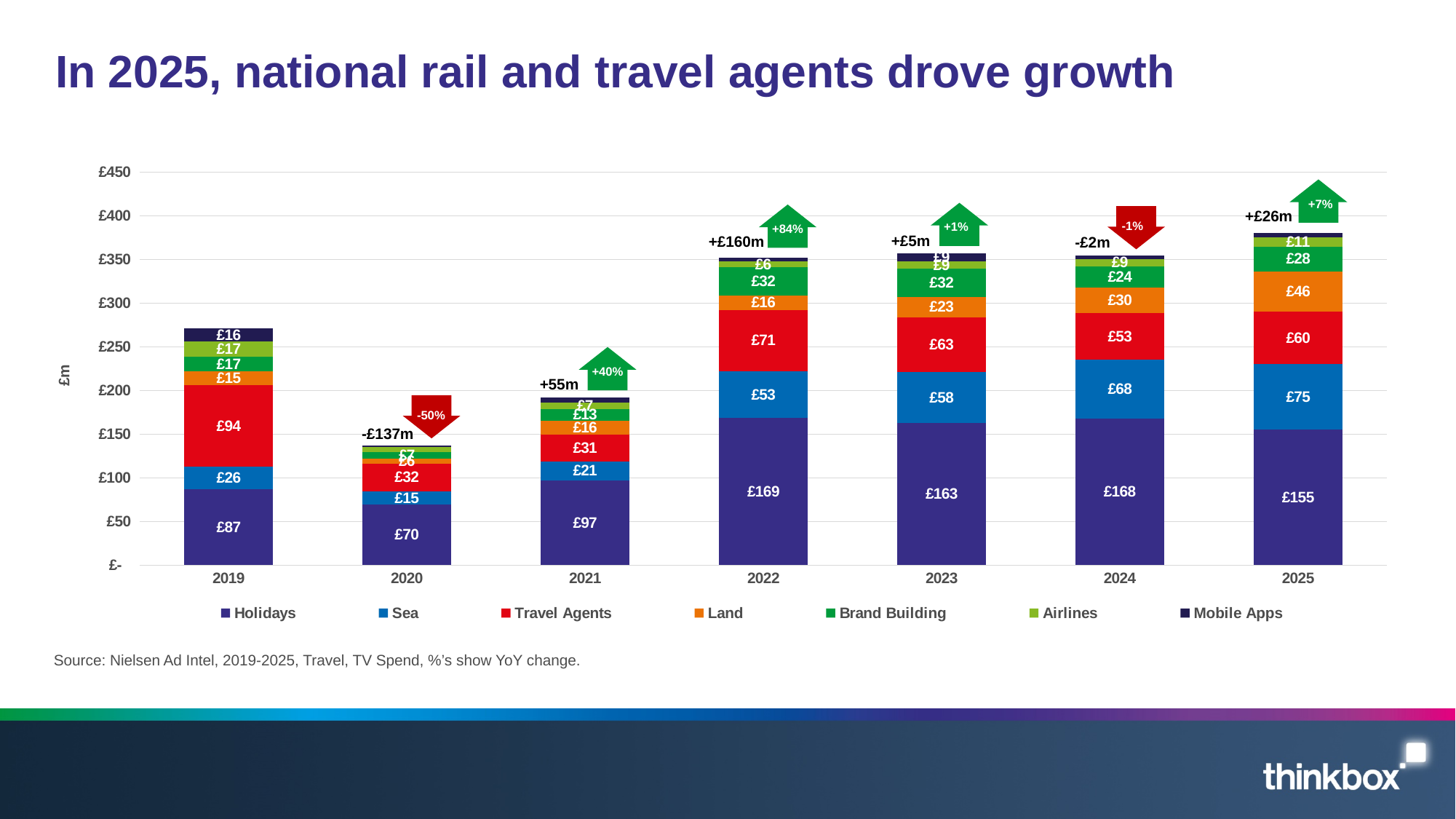
Is the total height of the 2025 bar greater or less than £350? greater In which year is the Holidays segment highest? 2022 Which is larger, the Sea value in 2024 or in 2025? 2025 What kind of chart is shown on the slide? Stacked bar chart In which year is the Holidays segment lowest? 2020 What is the value for Travel Agents in 2019? £94 How many years are shown on the x axis? 7 How many series does the legend list? 7 What is the difference between the Travel Agents value in 2019 and in 2025? £34 What is the value for Land in 2025? £46 What year-on-year percentage change is shown above the 2022 bar? +84% What is the value for Holidays in 2022? £169